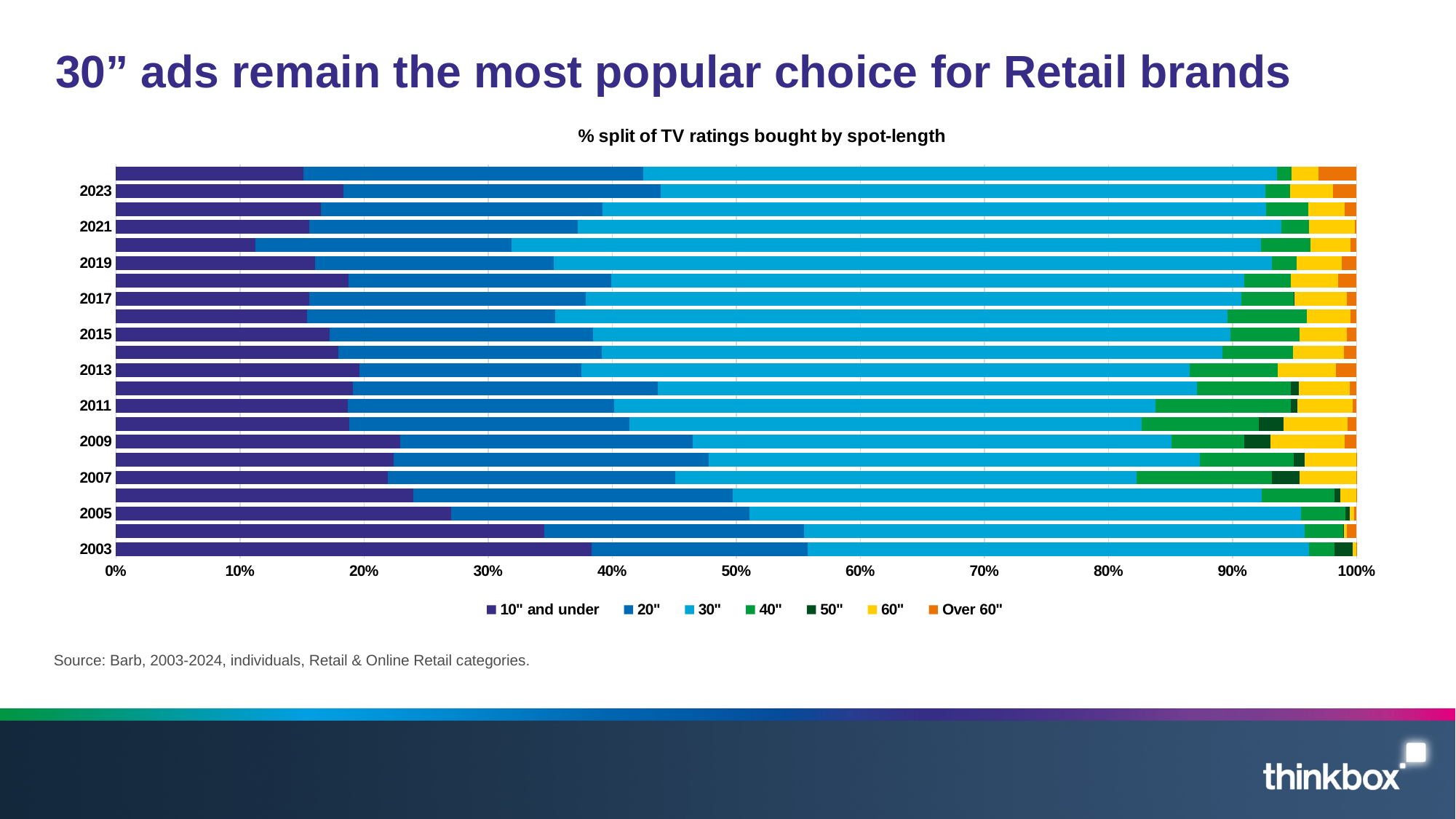
How many series does the legend list? 7 Which year has the larger share of 20" ads, 2003 or 2023? 2023 Which labelled year has the largest share of 10" and under ads? 2003 Is the share of 10" and under ads in 2019 greater or less than 20%? less Is the share of 10" and under ads in 2023 greater or less than 20%? less Which year has the larger share of 10" and under ads, 2003 or 2023? 2003 Is the share of 10" and under ads in 2003 greater or less than 30%? greater Does the share of 10" and under ads generally rise or fall from 2003 to 2023? fall What kind of chart is shown on the slide? Stacked bar chart How many years are labelled on the vertical axis of the chart? 11 What is the title of the chart? % split of TV ratings bought by spot-length